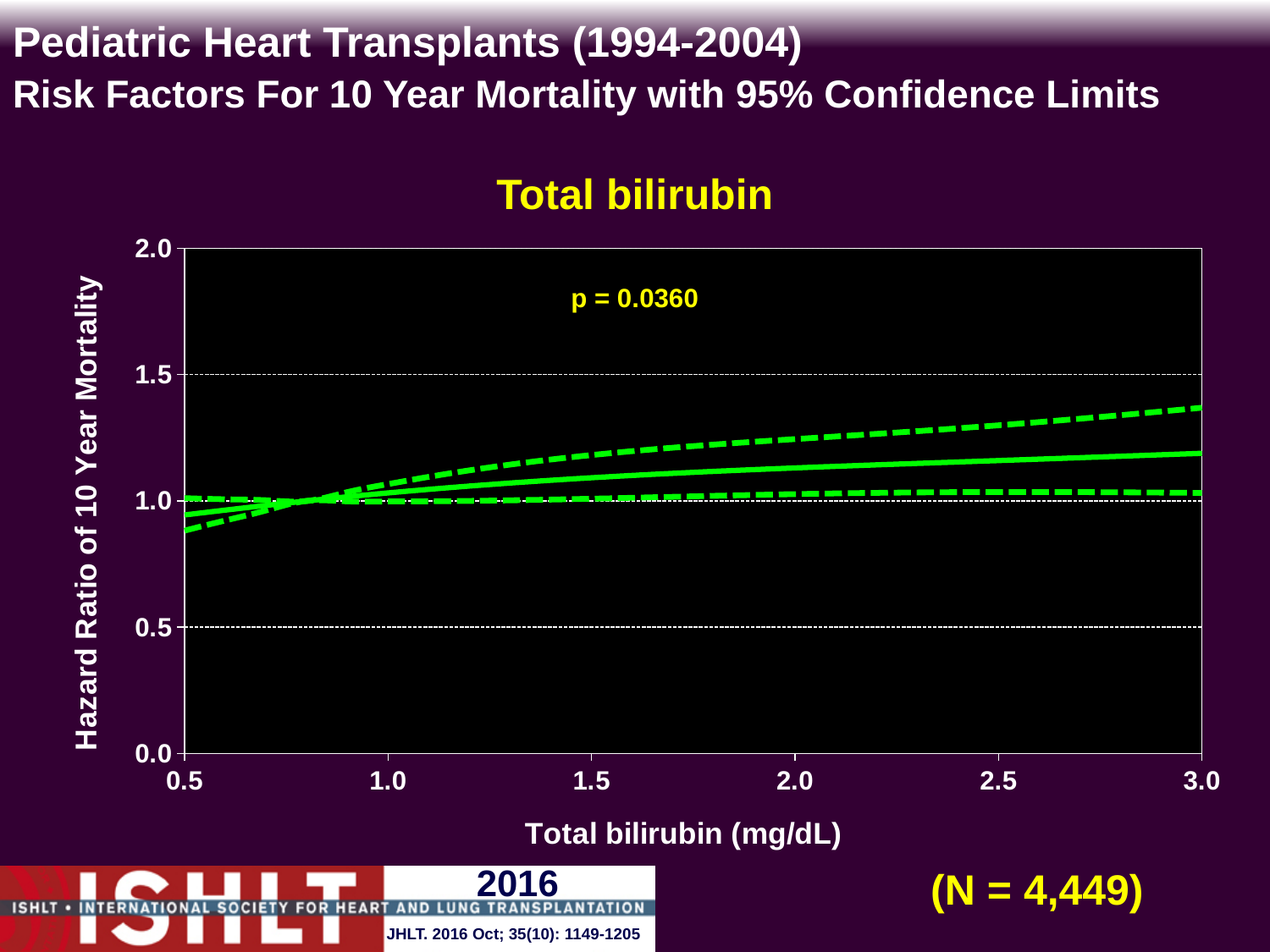
How many lines are plotted on the chart? 3 Is the lower confidence limit at a total bilirubin of 3.0 mg/dL greater or less than 0.5? greater Does the solid hazard ratio line rise or fall as total bilirubin increases from 0.5 to 3.0 mg/dL? rise Is the upper confidence limit at a total bilirubin of 3.0 mg/dL greater or less than 1.5? less Is the hazard ratio (solid line) at a total bilirubin of 3.0 mg/dL greater or less than 1.0? greater What is the maximum value shown on the y axis? 2.0 What kind of chart is shown on the slide? line chart What is the label of the x axis? Total bilirubin (mg/dL) What p-value is printed on the chart? p = 0.0360